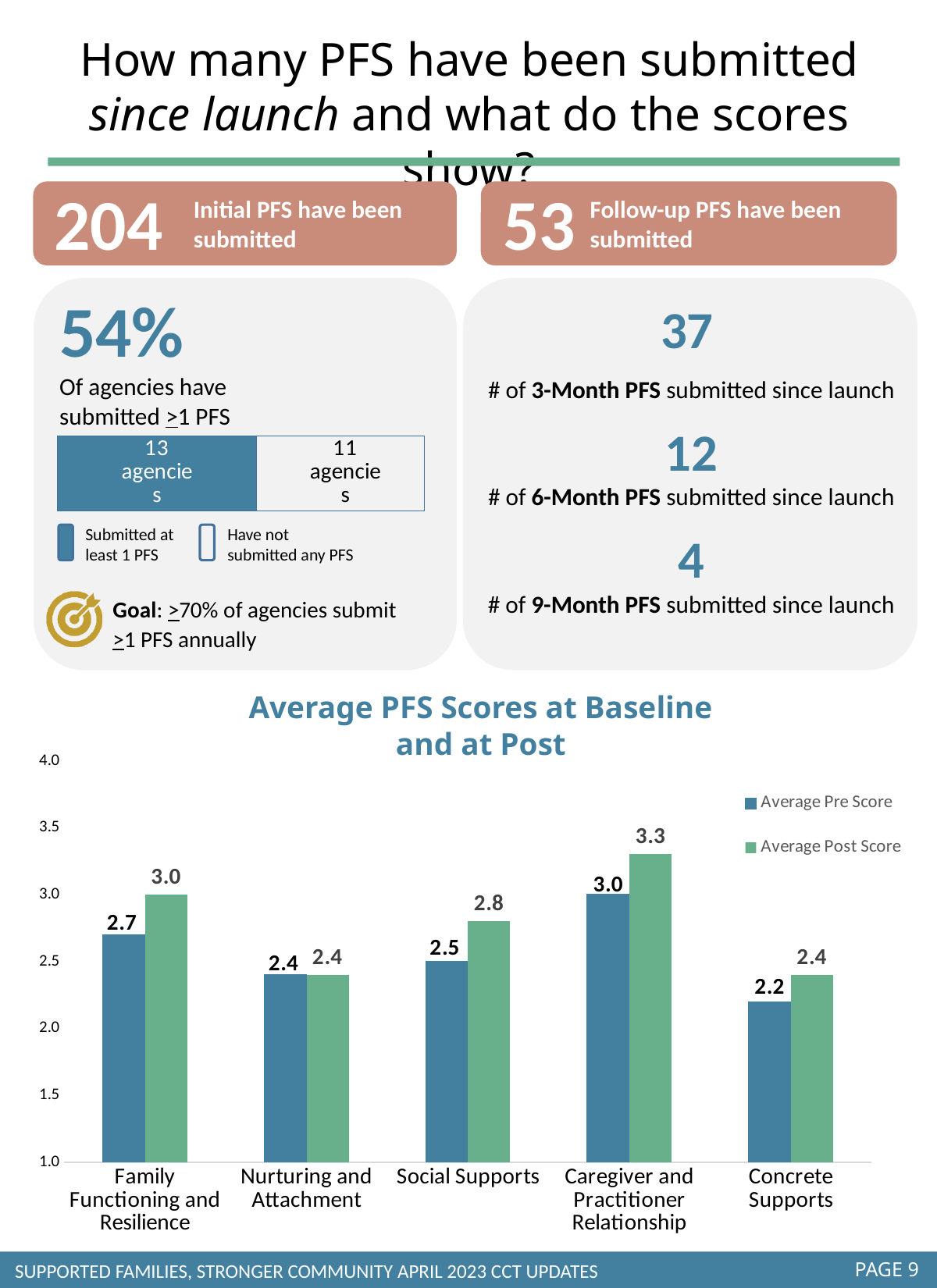
In the chart 'Average PFS Scores at Baseline and at Post', what is the Average Pre Score for Nurturing and Attachment? 2.4 In the chart 'Average PFS Scores at Baseline and at Post', how many categories are shown on the x axis? 5 In the chart 'Average PFS Scores at Baseline and at Post', how many series does the legend list? 2 In the chart 'Average PFS Scores at Baseline and at Post', what is the Average Post Score for Social Supports? 2.8 In the chart 'Average PFS Scores at Baseline and at Post', what is the Average Post Score for Caregiver and Practitioner Relationship? 3.3 In the small bar showing agencies that have submitted PFS, how many agencies have submitted at least 1 PFS? 13 agencies In the chart 'Average PFS Scores at Baseline and at Post', what is the difference between the Average Post Score and the Average Pre Score for Social Supports? 0.3 In the chart 'Average PFS Scores at Baseline and at Post', what is the Average Pre Score for Family Functioning and Resilience? 2.7 In the chart 'Average PFS Scores at Baseline and at Post', which category has the highest Average Pre Score? Caregiver and Practitioner Relationship In the chart 'Average PFS Scores at Baseline and at Post', which category has the lowest Average Pre Score? Concrete Supports What kind of chart is 'Average PFS Scores at Baseline and at Post'? Bar chart In the chart 'Average PFS Scores at Baseline and at Post', which is larger for Concrete Supports: the Average Pre Score or the Average Post Score? Average Post Score